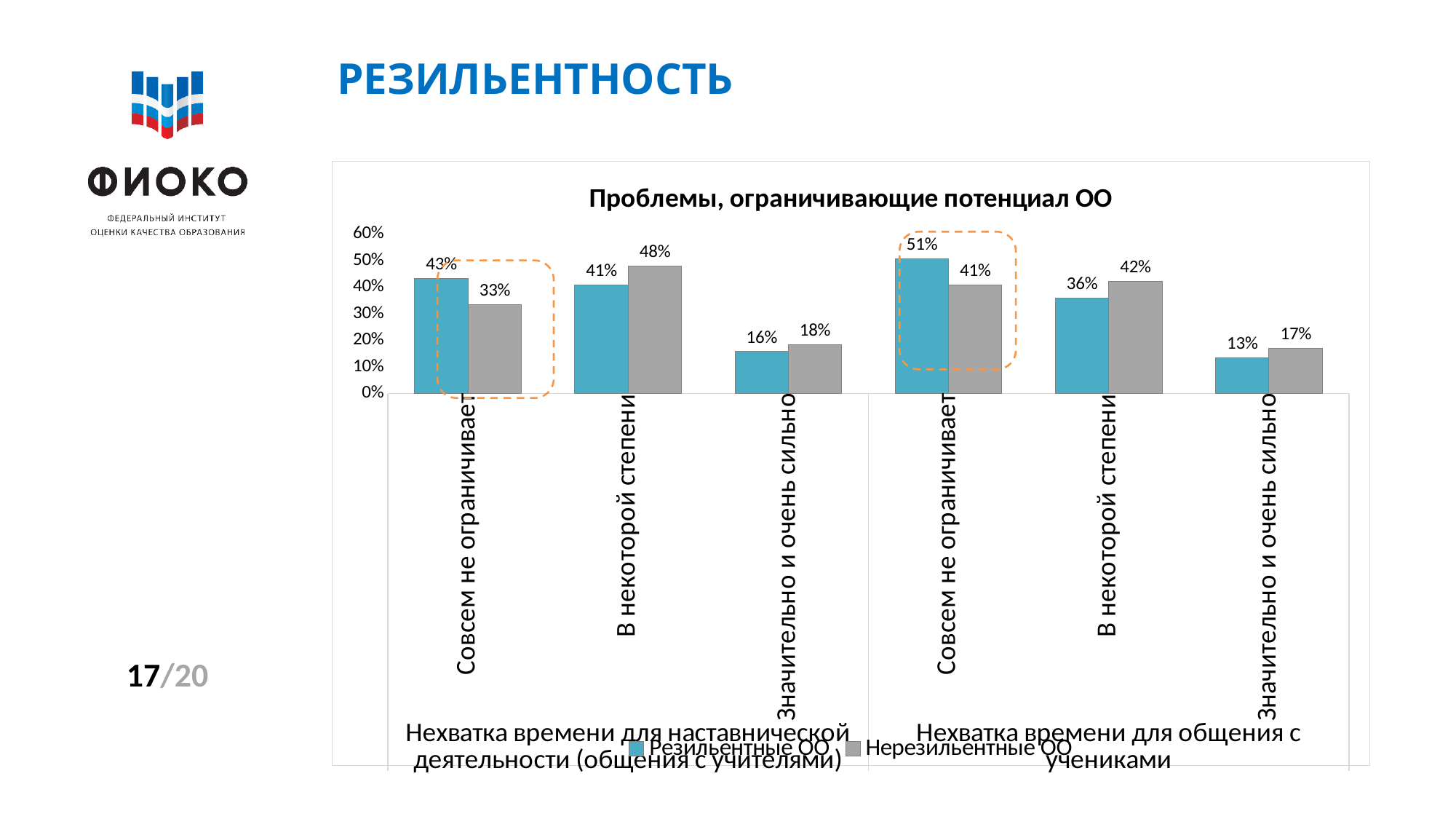
What type of chart is shown on the slide? Bar chart What is the value for Нерезильентные ОО in the category "Значительно и очень сильно" under "Нехватка времени для общения с учениками"? 17% What is the difference between Резильентные ОО and Нерезильентные ОО in the category "Совсем не ограничивает" under "Нехватка времени для общения с учениками"? 10% How many series does the legend list? 2 What is the value for Резильентные ОО in the category "Совсем не ограничивает" under "Нехватка времени для общения с учениками"? 51% Is the value for Нерезильентные ОО in "Совсем не ограничивает" under "Нехватка времени для наставнической деятельности (общения с учителями)" greater or less than 40%? less Which category has the lowest value for Резильентные ОО across the whole chart? Значительно и очень сильно (Нехватка времени для общения с учениками) What is the value for Нерезильентные ОО in the category "В некоторой степени" under "Нехватка времени для наставнической деятельности (общения с учителями)"? 48% What is the value for Резильентные ОО in the category "Совсем не ограничивает" under "Нехватка времени для наставнической деятельности (общения с учителями)"? 43% What is the title of the chart? Проблемы, ограничивающие потенциал ОО In the category "В некоторой степени" under "Нехватка времени для общения с учениками", which series has the larger value: Резильентные ОО or Нерезильентные ОО? Нерезильентные ОО Which category has the highest value for Резильентные ОО across the whole chart? Совсем не ограничивает (Нехватка времени для общения с учениками)